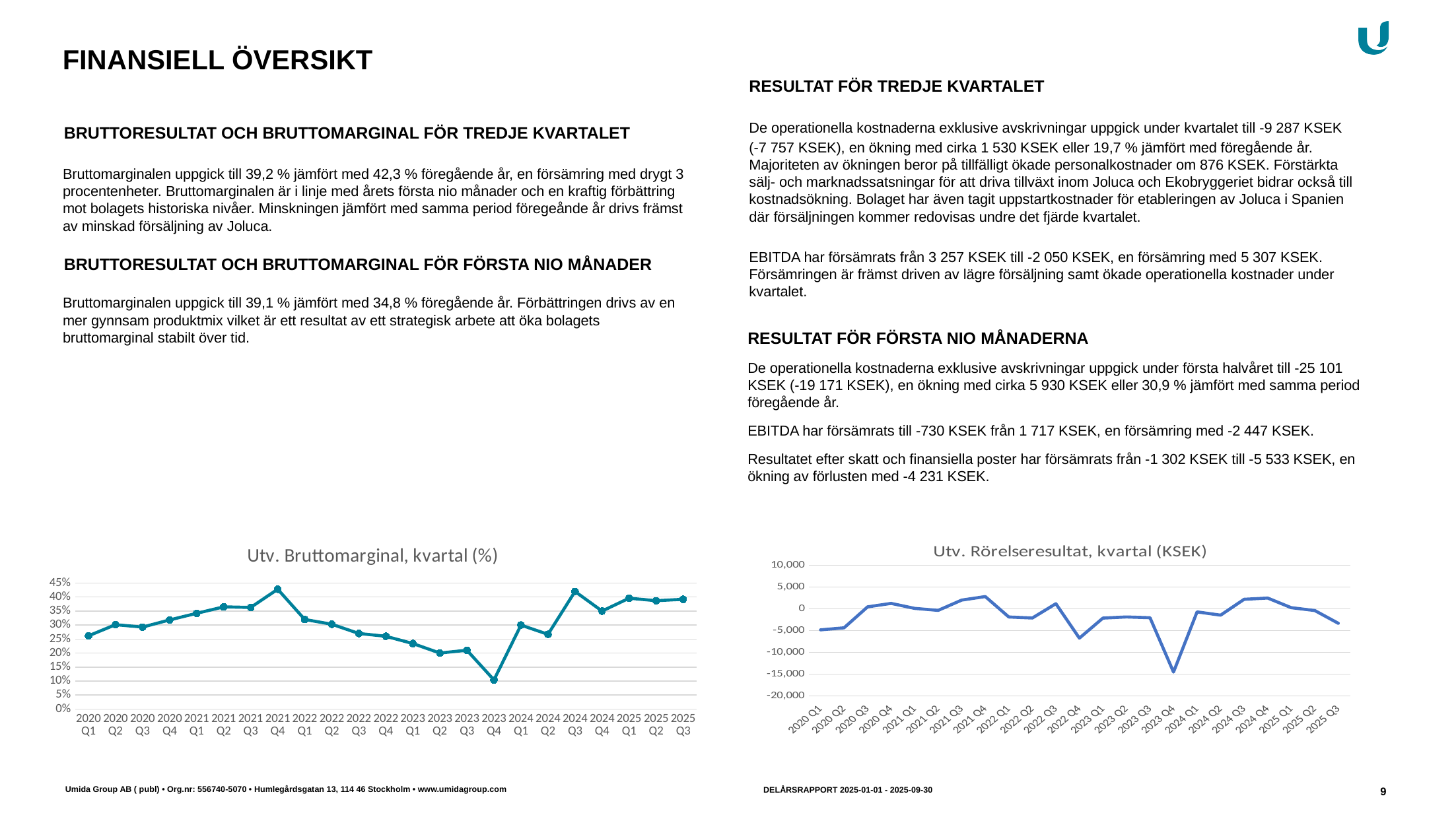
In the chart "Utv. Bruttomarginal, kvartal (%)", which quarter has the lowest gross margin? 2023 Q4 In the chart "Utv. Bruttomarginal, kvartal (%)", is the value for 2023 Q4 greater or less than 15%? less What is the title of the chart on the right side of the slide? Utv. Rörelseresultat, kvartal (KSEK) In the chart "Utv. Bruttomarginal, kvartal (%)", is the value for 2021 Q4 greater or less than 40%? greater In the chart "Utv. Rörelseresultat, kvartal (KSEK)", which is larger, the value for 2022 Q4 or the value for 2023 Q4? 2022 Q4 In the chart "Utv. Bruttomarginal, kvartal (%)", do the values rise or fall from 2021 Q4 to 2023 Q4? Fall In the chart "Utv. Rörelseresultat, kvartal (KSEK)", is the value for 2023 Q4 greater or less than -10,000? less In the chart "Utv. Bruttomarginal, kvartal (%)", which quarter has the highest gross margin? 2021 Q4 What type of chart is "Utv. Bruttomarginal, kvartal (%)"? Line chart In the chart "Utv. Rörelseresultat, kvartal (KSEK)", which quarter has the lowest operating result? 2023 Q4 How many quarters are plotted in the chart "Utv. Bruttomarginal, kvartal (%)"? 23